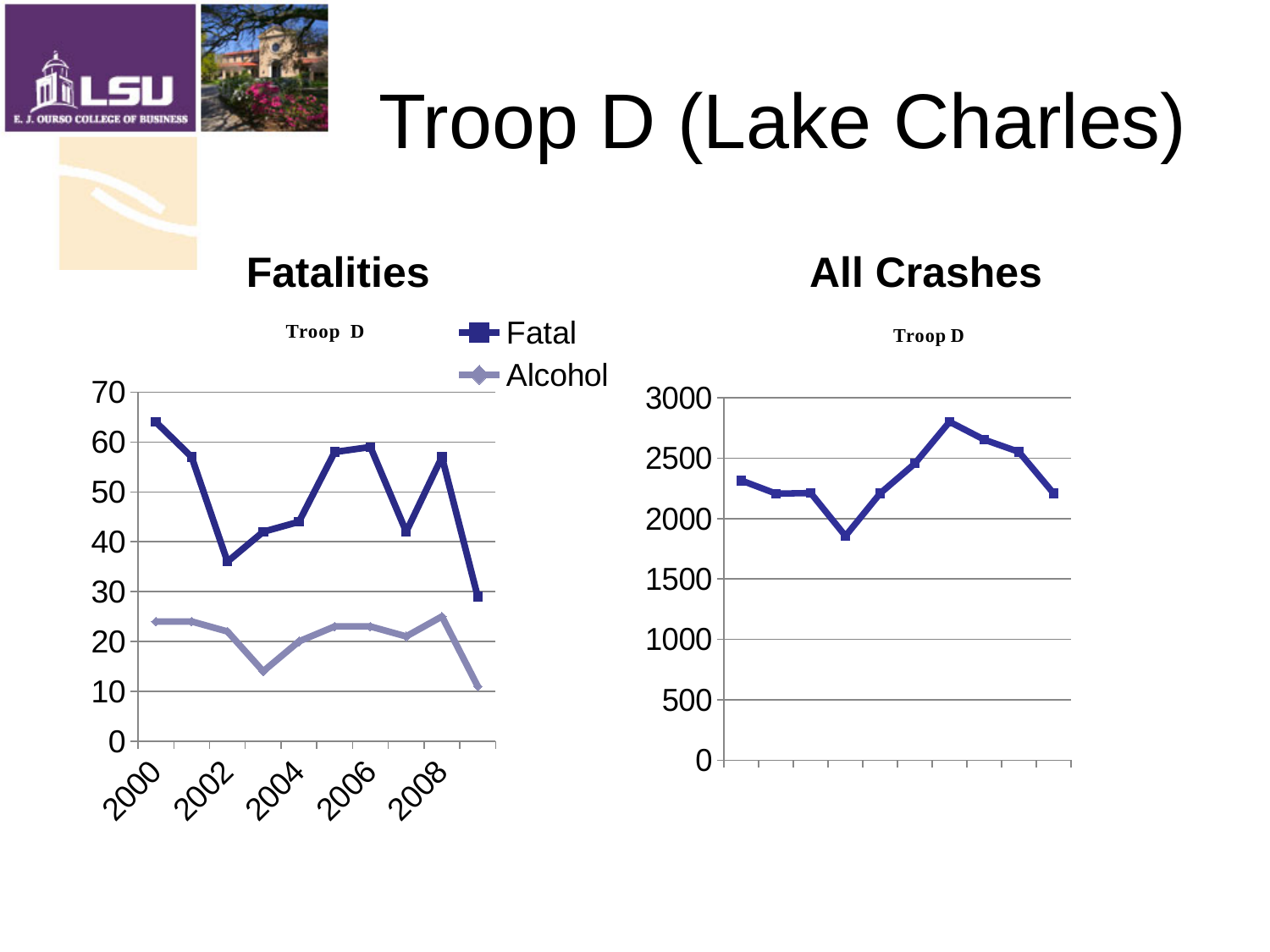
On the All Crashes chart, is the highest point greater or less than 2500? greater On the Fatalities chart, is the Fatal value for 2000 greater or less than 60? greater On the Fatalities chart, what are the names of the two series in the legend? Fatal and Alcohol On the Fatalities chart, does the Fatal series rise or fall between 2008 and 2009? fall On the All Crashes chart, is the lowest point greater or less than 2000? less On the Fatalities chart, in which year is the Fatal series at its lowest? 2009 On the Fatalities chart, what kind of chart is shown? line chart On the Fatalities chart, which series has the higher value in 2006, Fatal or Alcohol? Fatal On the Fatalities chart, in which year is the Fatal series at its highest? 2000 On the Fatalities chart, how many series does the legend list? 2 On the All Crashes chart, what kind of chart is shown? line chart